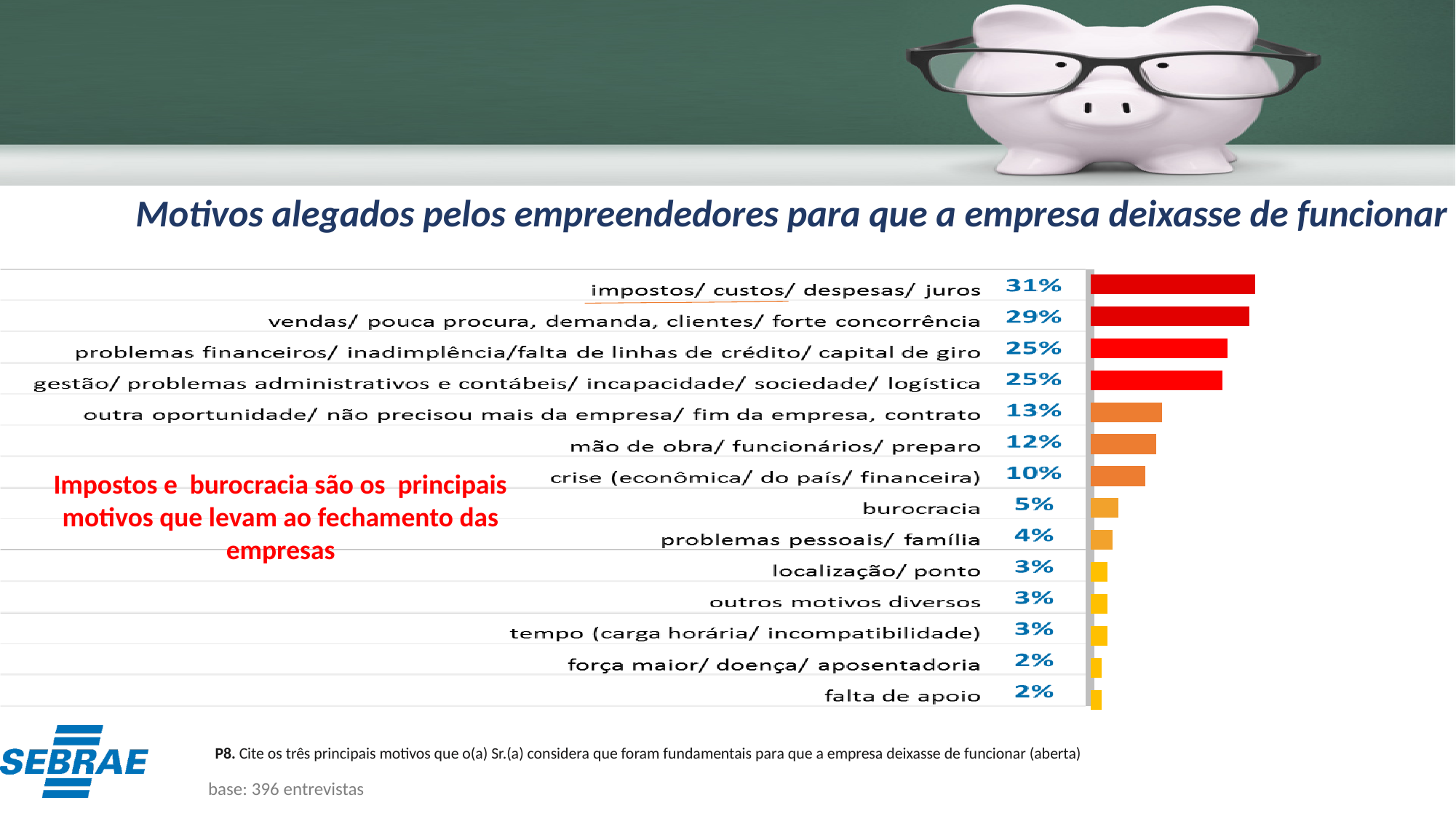
What kind of chart is shown on the slide? bar chart What is the title of the chart on the slide? Motivos alegados pelos empreendedores para que a empresa deixasse de funcionar Which category has the highest value? impostos/ custos/ despesas/ juros What is the value for "crise (econômica/ do país/ financeira)"? 10% What is the value for "mão de obra/ funcionários/ preparo"? 12% What is the difference between the values for "impostos/ custos/ despesas/ juros" and "vendas/ pouca procura, demanda, clientes/ forte concorrência"? 2% Which is larger: the value for "outra oportunidade/ não precisou mais da empresa/ fim da empresa, contrato" or the value for "mão de obra/ funcionários/ preparo"? outra oportunidade/ não precisou mais da empresa/ fim da empresa, contrato What is the difference between the values for "burocracia" and "falta de apoio"? 3% What is the value for "problemas pessoais/ família"? 4% How many categories are shown in the chart? 14 What is the value for "burocracia"? 5% What is the value for "impostos/ custos/ despesas/ juros"? 31%